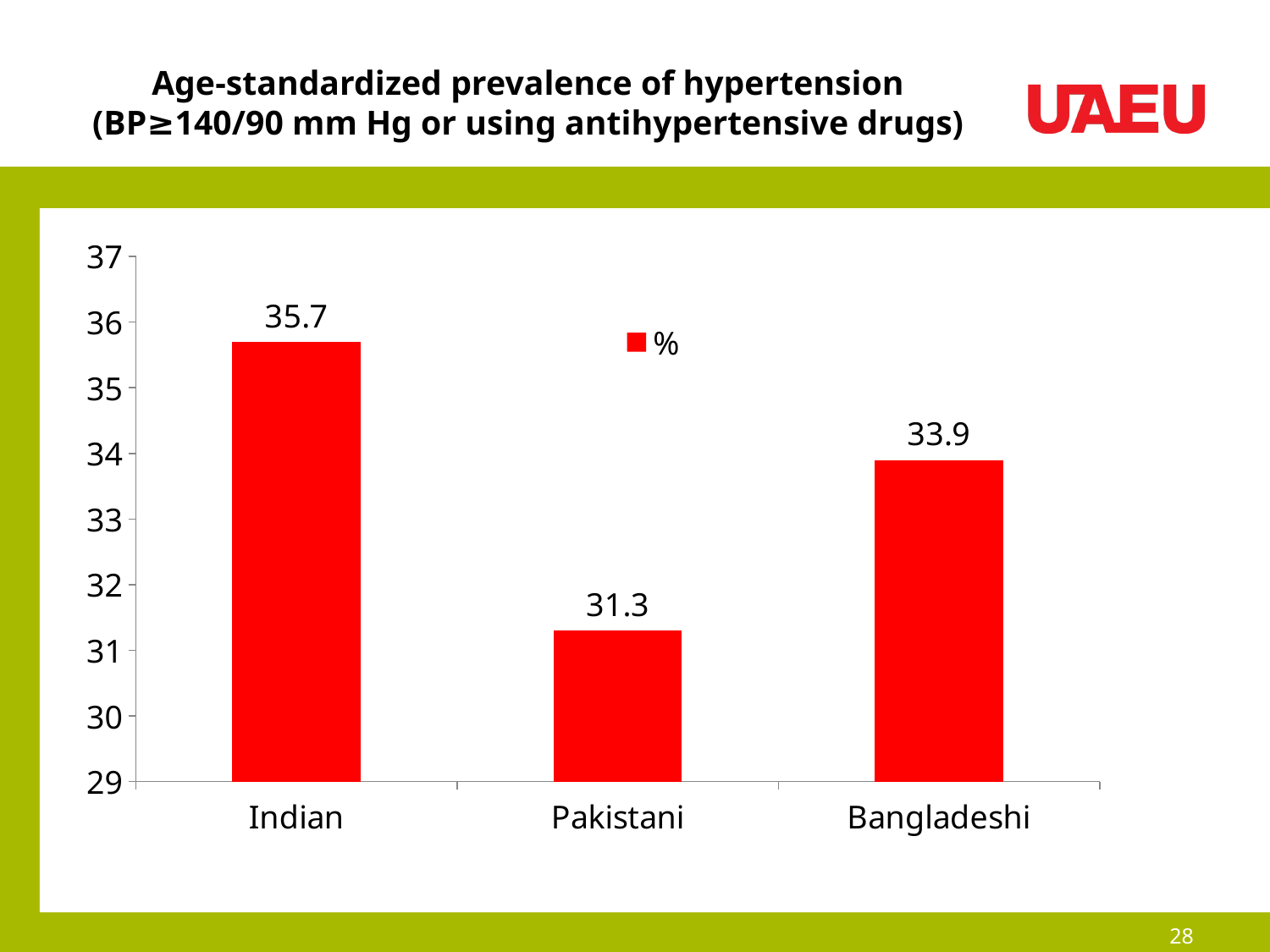
Is the value for Indian greater or less than 35? greater What is the difference between the prevalence for Bangladeshi and Pakistani? 2.6 How many groups are shown on the x axis? 3 Which is larger, the prevalence for Bangladeshi or for Pakistani? Bangladeshi What is the legend entry for the series shown? % Which group has the lowest prevalence of hypertension? Pakistani Which group has the highest prevalence of hypertension? Indian What is the difference between the prevalence for Indian and Pakistani? 4.4 What is the age-standardized prevalence of hypertension for Pakistani? 31.3 What is the age-standardized prevalence of hypertension for Indian? 35.7 What is the age-standardized prevalence of hypertension for Bangladeshi? 33.9 What kind of chart is shown on the slide? Bar chart